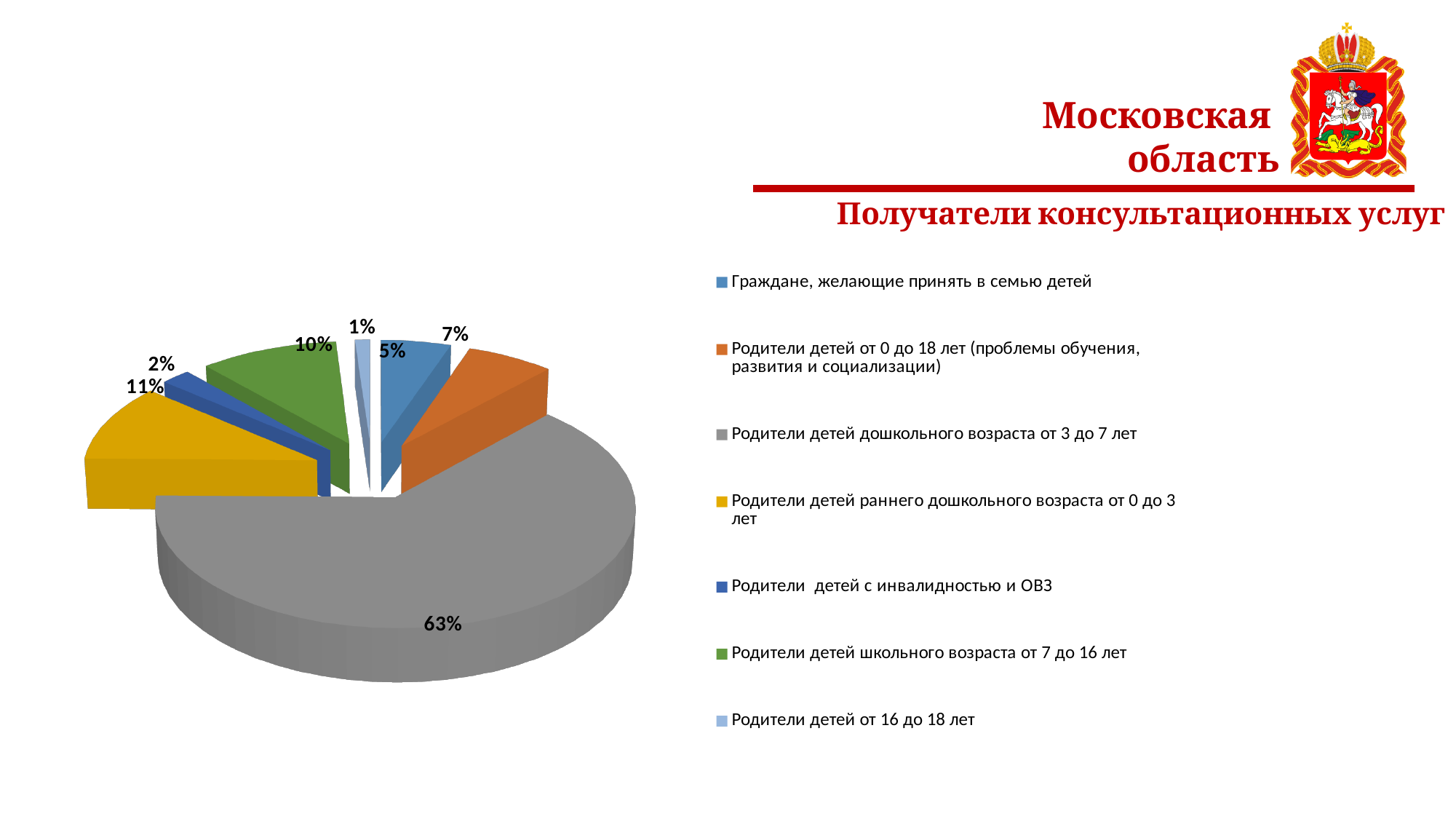
What share of the pie is 'Родители детей дошкольного возраста от 3 до 7 лет'? 63% What is the difference between the shares of 'Родители детей раннего дошкольного возраста от 0 до 3 лет' and 'Родители детей школьного возраста от 7 до 16 лет'? 1% What share of the pie is 'Родители детей раннего дошкольного возраста от 0 до 3 лет'? 11% What share of the pie is 'Родители детей школьного возраста от 7 до 16 лет'? 10% How many categories does the legend of the pie chart list? 7 What kind of chart is shown on the slide? Pie chart Which is larger: the share of 'Родители детей от 0 до 18 лет (проблемы обучения, развития и социализации)' or the share of 'Граждане, желающие принять в семью детей'? Родители детей от 0 до 18 лет (проблемы обучения, развития и социализации) Which category has the smallest slice of the pie? Родители детей от 16 до 18 лет What is the title of the chart on the slide? Получатели консультационных услуг Which category has the largest slice of the pie? Родители детей дошкольного возраста от 3 до 7 лет